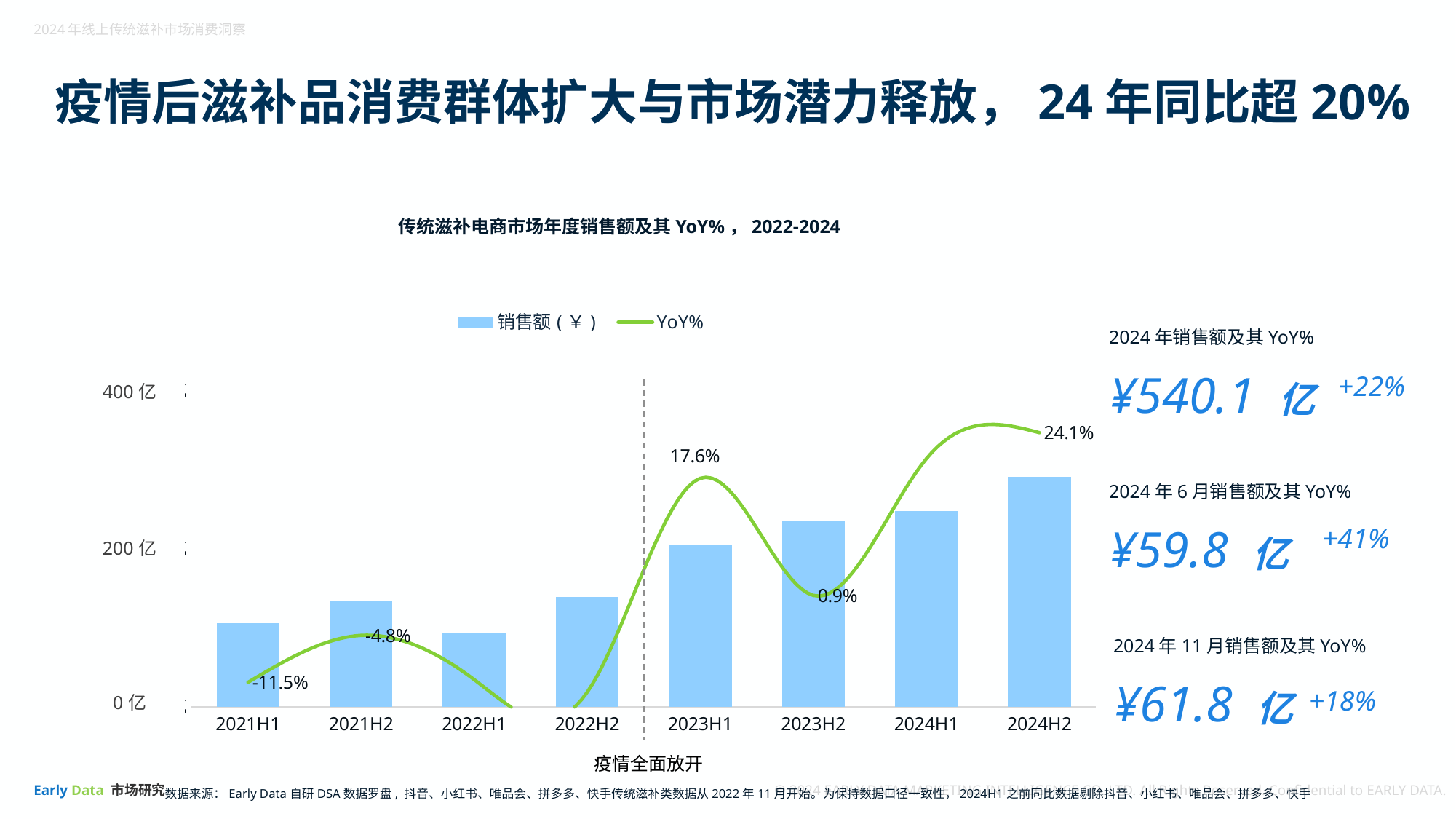
How many periods are shown on the x axis of the chart? 8 Is the 销售额 value for 2021H2 greater or less than 200 亿? less Is the 销售额 value for 2024H1 greater or less than 200 亿? greater How many series does the chart legend list? 2 What is the YoY% value shown for 2023H2? 0.9% What is the YoY% value shown for 2021H1? -11.5% What kind of chart is shown on the slide? Combined bar and line chart Which period has the highest labelled YoY% value? 2024H2 What is the YoY% value shown for 2024H2? 24.1% Which period has the lowest labelled YoY% value? 2021H1 Which period has the taller 销售额 bar, 2024H2 or 2021H1? 2024H2 What is the difference between the YoY% for 2024H2 and the YoY% for 2023H1? 6.5 percentage points